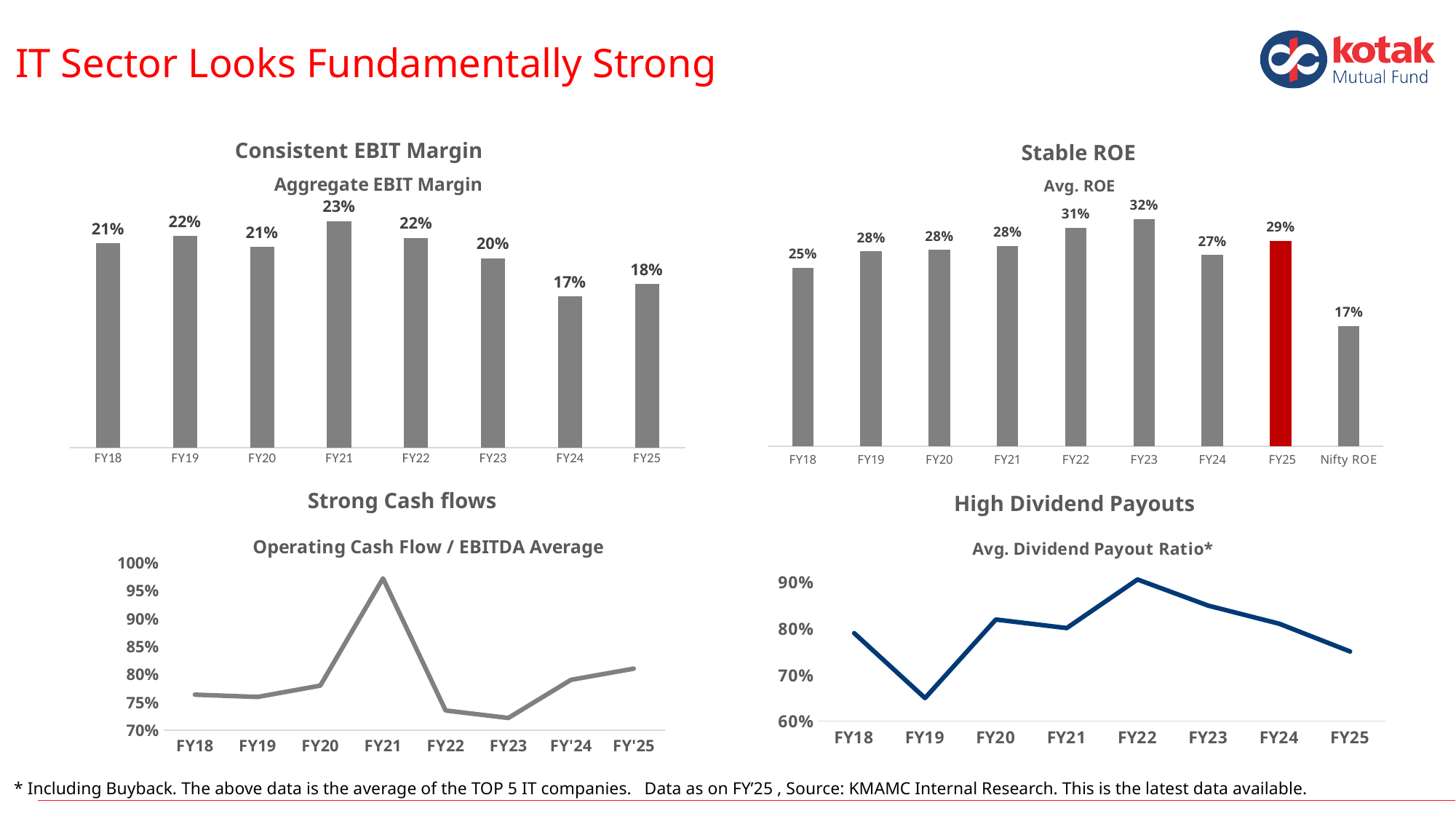
What kind of chart is the Avg. Dividend Payout Ratio chart? line chart In the Aggregate EBIT Margin chart, what is the difference between the FY21 and FY24 values? 6% In the Avg. ROE chart, what is the value for Nifty ROE? 17% In the Aggregate EBIT Margin chart, which year has the lowest EBIT margin? FY24 In the Avg. ROE chart, which category has the highest value? FY23 In the Avg. Dividend Payout Ratio chart, is the value for FY19 greater or less than 70%? less In the Avg. ROE chart, which is larger, the FY25 value or the Nifty ROE value? FY25 In the Operating Cash Flow / EBITDA Average chart, is the value for FY21 greater or less than 95%? greater In the Avg. ROE chart, how many bars are plotted? 9 In the Avg. ROE chart, which bar is highlighted in red? FY25 In the Aggregate EBIT Margin chart, what is the value for FY21? 23% In the Operating Cash Flow / EBITDA Average chart, is the value for FY23 greater or less than 75%? less